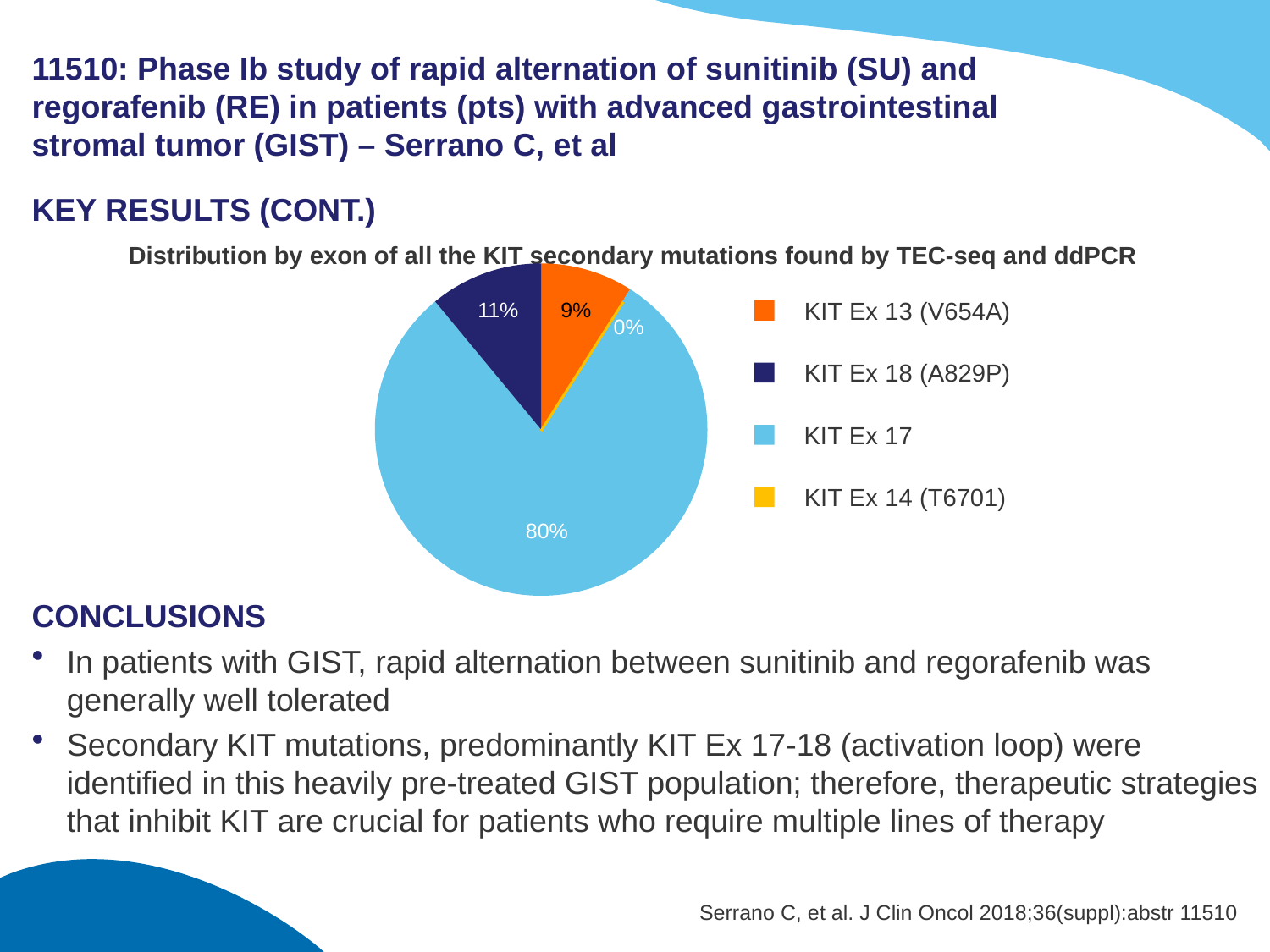
What kind of chart is shown on the slide? pie chart What percentage of the pie is KIT Ex 14 (T6701)? 0% What percentage of the pie is KIT Ex 17? 80% What is the difference in percentage points between KIT Ex 17 and KIT Ex 18 (A829P)? 69 Which category has the largest share of the pie? KIT Ex 17 What is the title of the pie chart? Distribution by exon of all the KIT secondary mutations found by TEC-seq and ddPCR What percentage of the pie is KIT Ex 18 (A829P)? 11% What percentage of the pie is KIT Ex 13 (V654A)? 9% How many categories does the legend list? 4 What colour represents KIT Ex 13 (V654A) in the pie chart? orange Which is larger, the share for KIT Ex 18 (A829P) or KIT Ex 13 (V654A)? KIT Ex 18 (A829P) Which category has the smallest share of the pie? KIT Ex 14 (T6701)